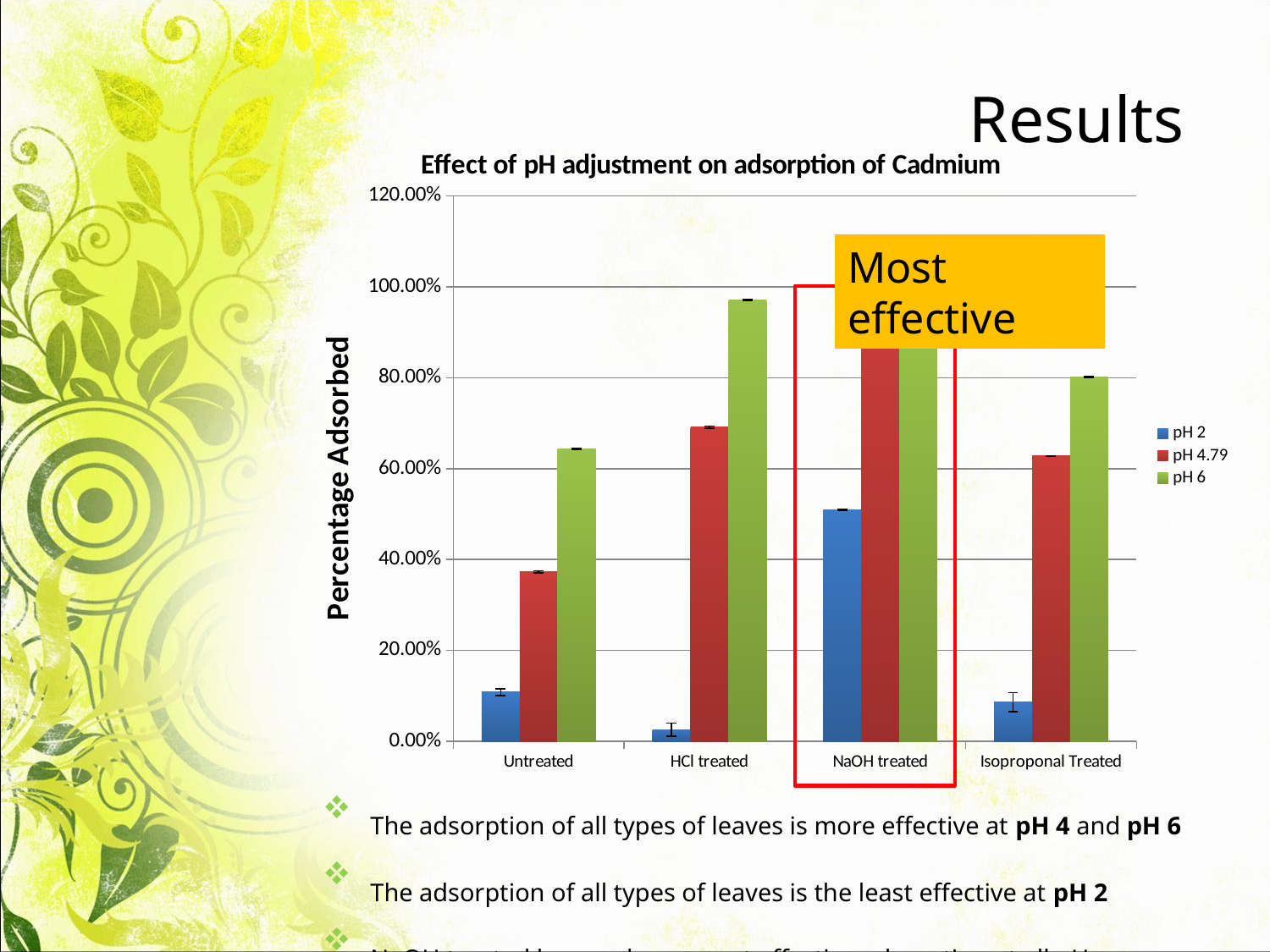
What kind of chart is shown on the slide? bar chart Is the pH 4.79 value for Untreated greater or less than 40.00%? less Which treatment category is highlighted with the red box and labelled 'Most effective'? NaOH treated How many treatment categories are shown on the x axis? 4 Is the pH 2 value for Untreated greater or less than 20.00%? less How many series does the legend list? 3 Which treatment has the lowest pH 2 value? HCl treated Is the pH 6 value for HCl treated greater or less than 80.00%? greater Which treatment has the highest pH 2 value? NaOH treated What is the title of the chart? Effect of pH adjustment on adsorption of Cadmium For Isoproponal Treated, which is larger: the pH 4.79 value or the pH 6 value? pH 6